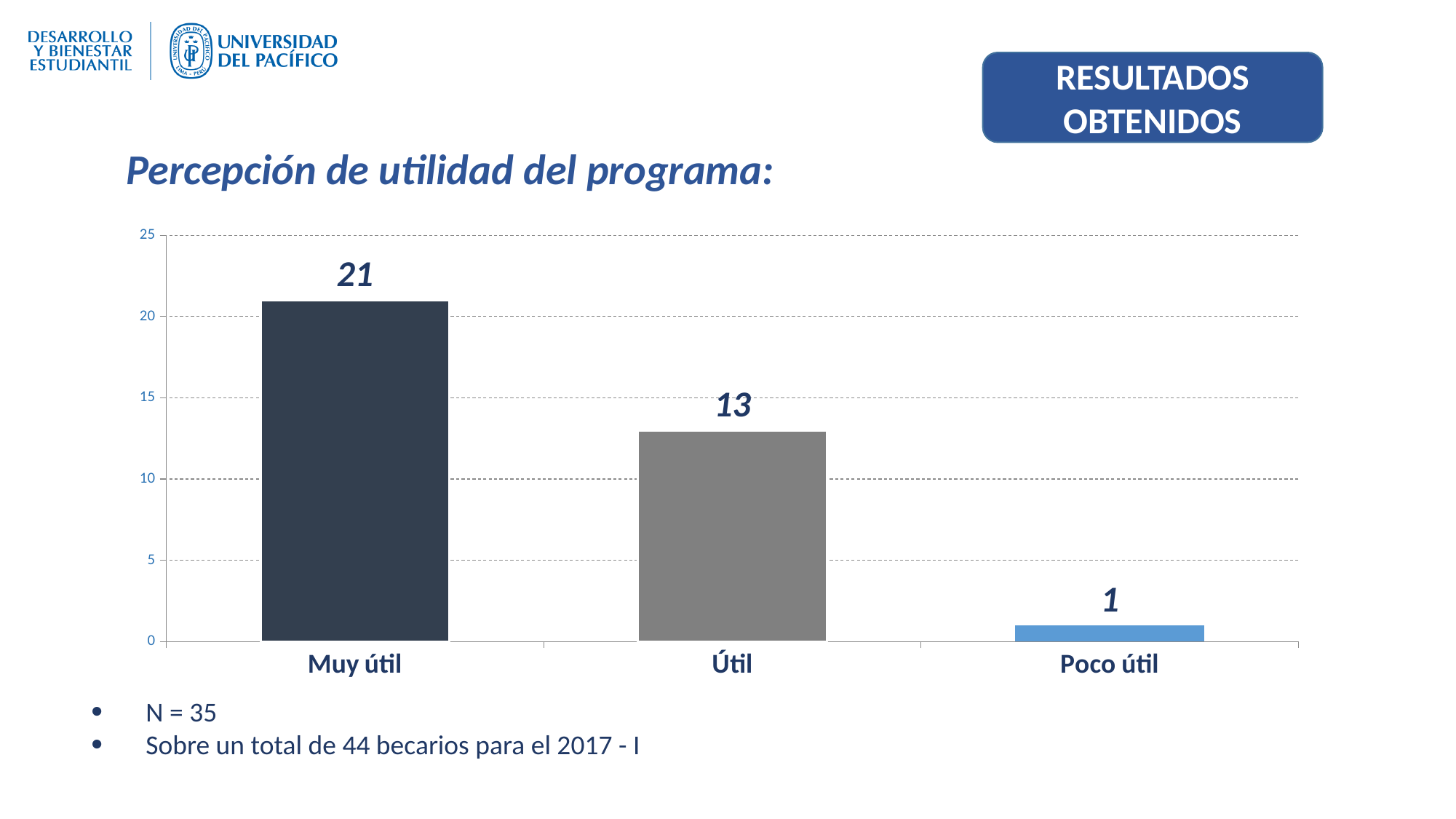
Which category has the lowest value? Poco útil Which category has the highest value? Muy útil How many categories are shown on the x axis? 3 What is the difference between the values for "Muy útil" and "Útil"? 8 What is the value for "Útil"? 13 Which is larger, the value for "Útil" or the value for "Poco útil"? Útil Is the value for "Muy útil" greater or less than 20? greater Do the values rise or fall from left to right along the x axis? fall What kind of chart is shown on the slide? bar chart What is the difference between the values for "Útil" and "Poco útil"? 12 What is the value for "Muy útil"? 21 What is the value for "Poco útil"? 1